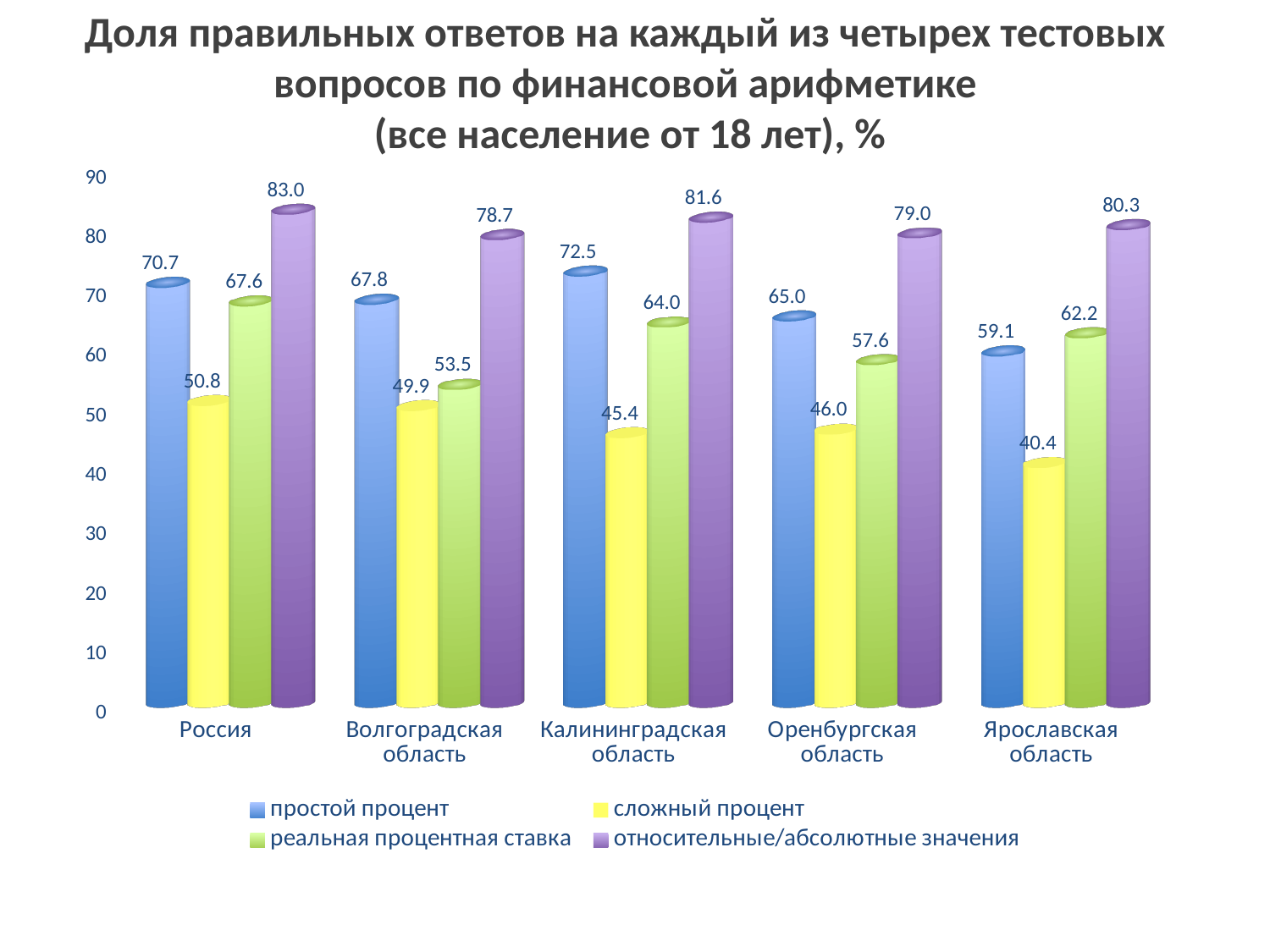
Which region has the lowest value for "сложный процент"? Ярославская область What is the value for "сложный процент" in Ярославская область? 40.4 What is the value for "простой процент" in Россия? 70.7 Which colour represents "сложный процент" in the legend? yellow Which region has the highest value for "относительные/абсолютные значения"? Россия What is the value for "относительные/абсолютные значения" in Калининградская область? 81.6 Is the value for "простой процент" in Ярославская область greater or less than 50? greater What kind of chart is shown on the slide? bar chart How many regions (categories) are shown on the x axis? 5 Which is larger: "реальная процентная ставка" in Волгоградская область or in Калининградская область? Калининградская область What is the difference between "простой процент" and "сложный процент" in Оренбургская область? 19.0 How many series does the legend list? 4